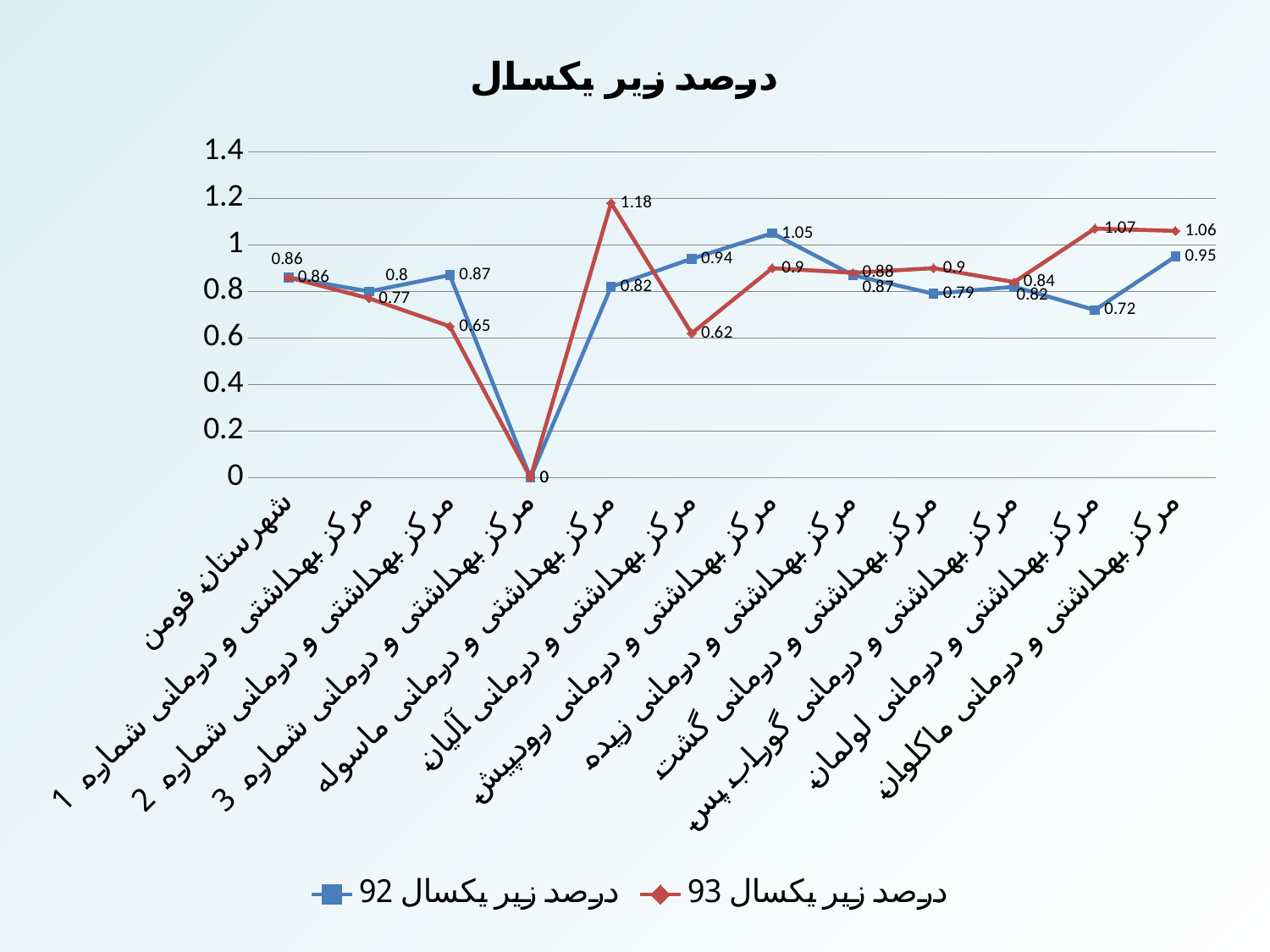
What is the title of the chart? درصد زیر یکسال Which category has the highest value in the series درصد زیر یکسال 93? مرکز بهداشتی و درمانی ماسوله What is the difference between the درصد زیر یکسال 93 and درصد زیر یکسال 92 values for مرکز بهداشتی و درمانی لولمان? 0.35 What is the value of the series درصد زیر یکسال 92 for مرکز بهداشتی و درمانی لولمان? 0.72 How many series does the legend list? 2 Which category has the highest value in the series درصد زیر یکسال 92? مرکز بهداشتی و درمانی رودپیش For مرکز بهداشتی و درمانی آلیان, which series has the larger value, درصد زیر یکسال 92 or درصد زیر یکسال 93? درصد زیر یکسال 92 What is the value of the series درصد زیر یکسال 92 for شهرستان فومن? 0.86 What type of chart is shown on the slide? line chart What is the value of the series درصد زیر یکسال 93 for مرکز بهداشتی و درمانی ماسوله? 1.18 Which category has the lowest value in both series? مرکز بهداشتی و درمانی شماره 3 How many categories are plotted along the x axis? 12